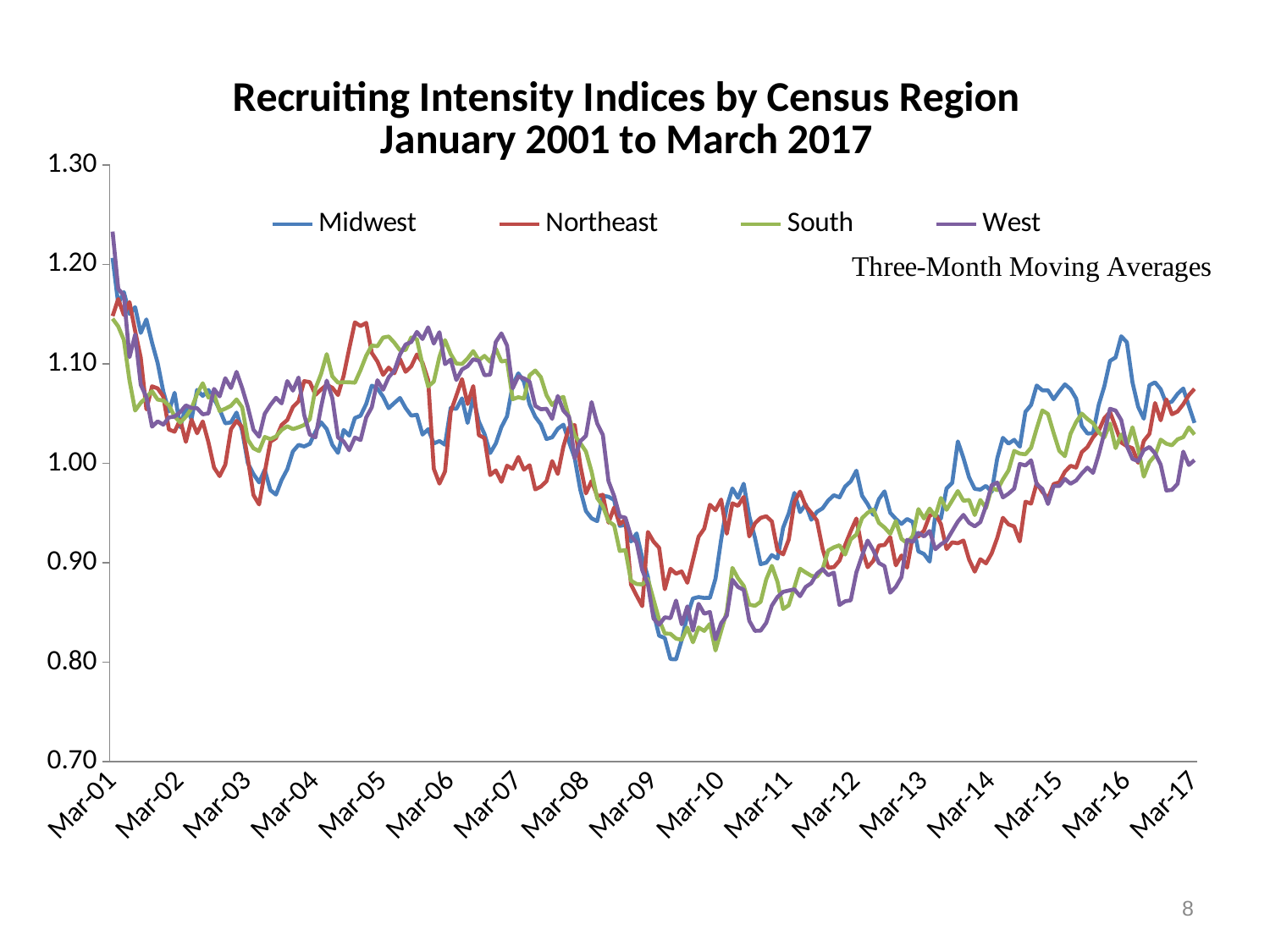
Is the peak of the Midwest line near Mar-16 greater or less than 1.10? greater Is the value for West at Mar-01 greater or less than 1.20? greater What is the title of the chart? Recruiting Intensity Indices by Census Region January 2001 to March 2017 How many series does the legend list? 4 Is the value for Northeast at Mar-17 greater or less than 1.00? greater What kind of chart is shown on the slide? line chart Do the lines generally rise or fall between Mar-09 and Mar-15? rise What is the highest value shown on the y axis? 1.30 How many date labels are shown along the x axis? 17 Do the lines generally rise or fall between Mar-01 and Mar-03? fall Which four regions are listed in the chart legend? Midwest, Northeast, South, West